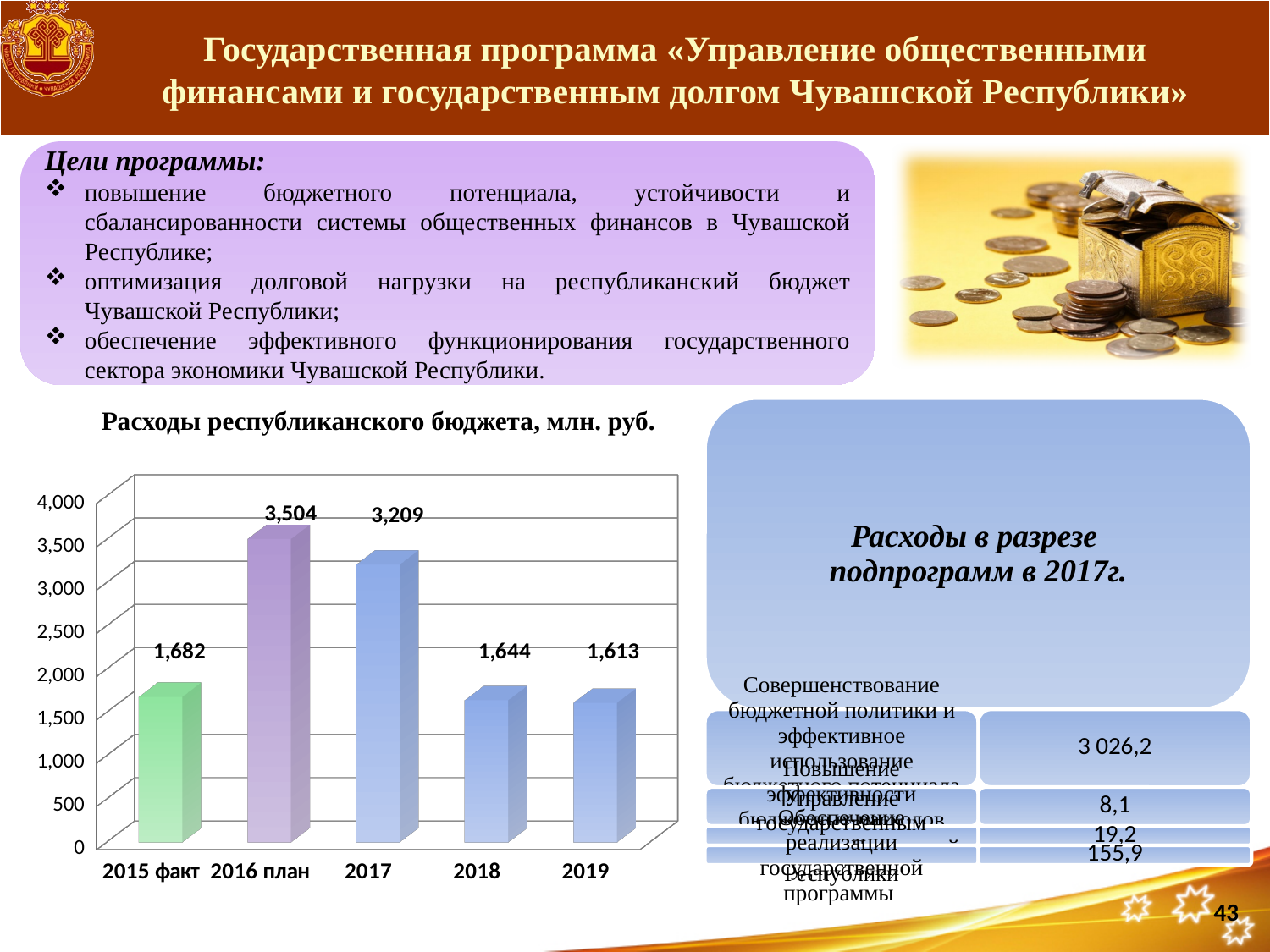
How many categories are shown on the x axis of the chart 'Расходы республиканского бюджета, млн. руб.'? 5 What is the value for 2015 факт in the chart 'Расходы республиканского бюджета, млн. руб.'? 1,682 What is the difference between the values for 2016 план and 2017 in the chart 'Расходы республиканского бюджета, млн. руб.'? 295 Which is larger in the chart 'Расходы республиканского бюджета, млн. руб.': the value for 2018 or the value for 2019? 2018 What is the value for 2017 in the chart 'Расходы республиканского бюджета, млн. руб.'? 3,209 What is the value for 2019 in the chart 'Расходы республиканского бюджета, млн. руб.'? 1,613 Do the values in the chart 'Расходы республиканского бюджета, млн. руб.' rise or fall from 2017 to 2019? fall Which category has the highest value in the chart 'Расходы республиканского бюджета, млн. руб.'? 2016 план Is the value for 2017 in the chart 'Расходы республиканского бюджета, млн. руб.' greater or less than 3,000? greater Which category has the lowest value in the chart 'Расходы республиканского бюджета, млн. руб.'? 2019 What is the value for 2016 план in the chart 'Расходы республиканского бюджета, млн. руб.'? 3,504 What kind of chart is 'Расходы республиканского бюджета, млн. руб.'? bar chart